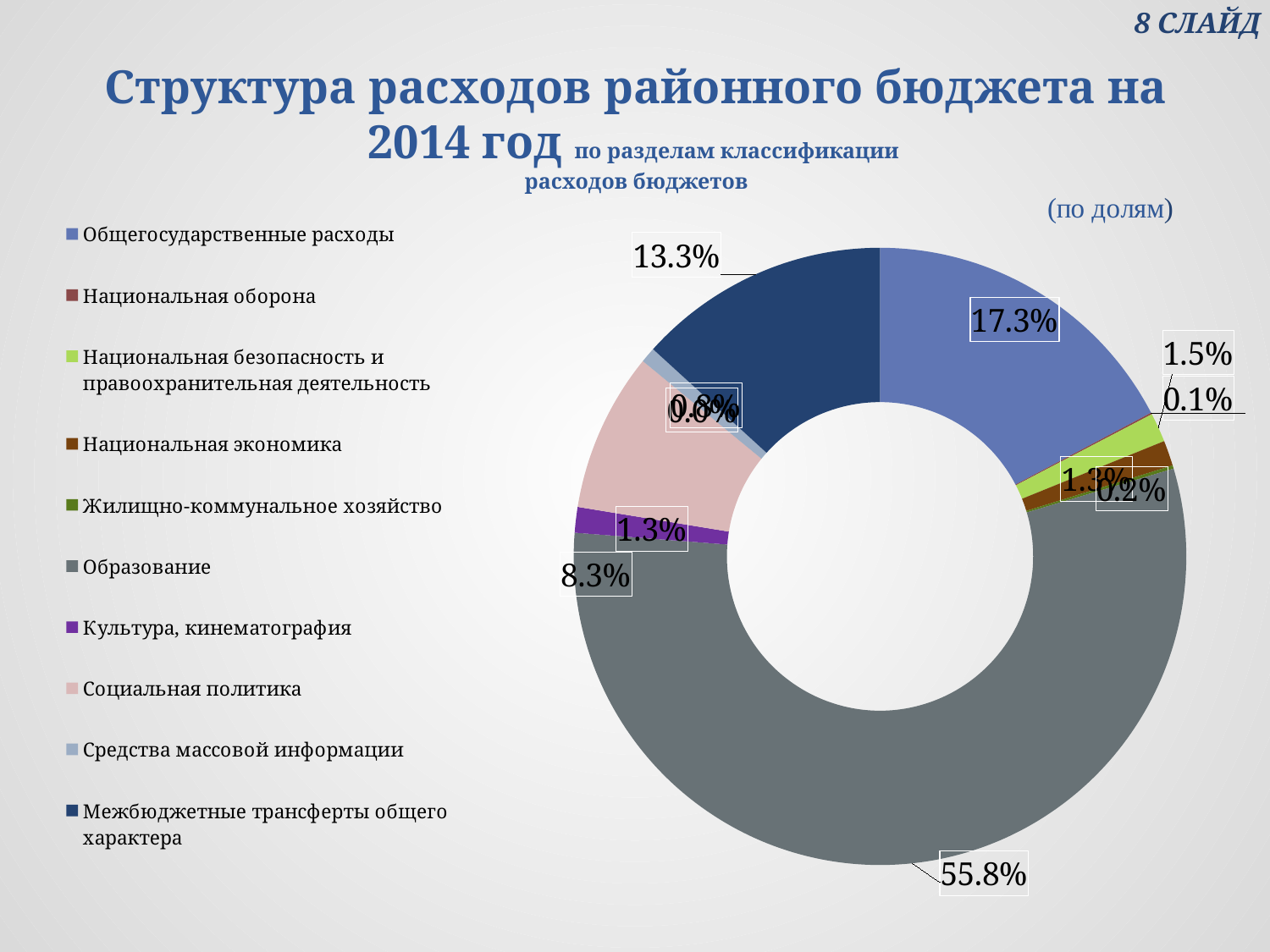
What share of expenditures goes to Культура, кинематография? 1.3% What kind of chart is shown on the slide? Doughnut (pie) chart What share of expenditures goes to Социальная политика? 8.3% What is the difference in percentage points between the shares of Образование and Общегосударственные расходы? 38.5 What share of expenditures goes to Образование? 55.8% For which year does the chart show the structure of district budget expenditures? 2014 What share of expenditures goes to Межбюджетные трансферты общего характера? 13.3% Which category has the smallest share of expenditures? Национальная оборона What share of expenditures goes to Общегосударственные расходы? 17.3% How many categories does the legend list? 10 Which has a larger share: Межбюджетные трансферты общего характера or Социальная политика? Межбюджетные трансферты общего характера Which category has the largest share of the district budget expenditures? Образование